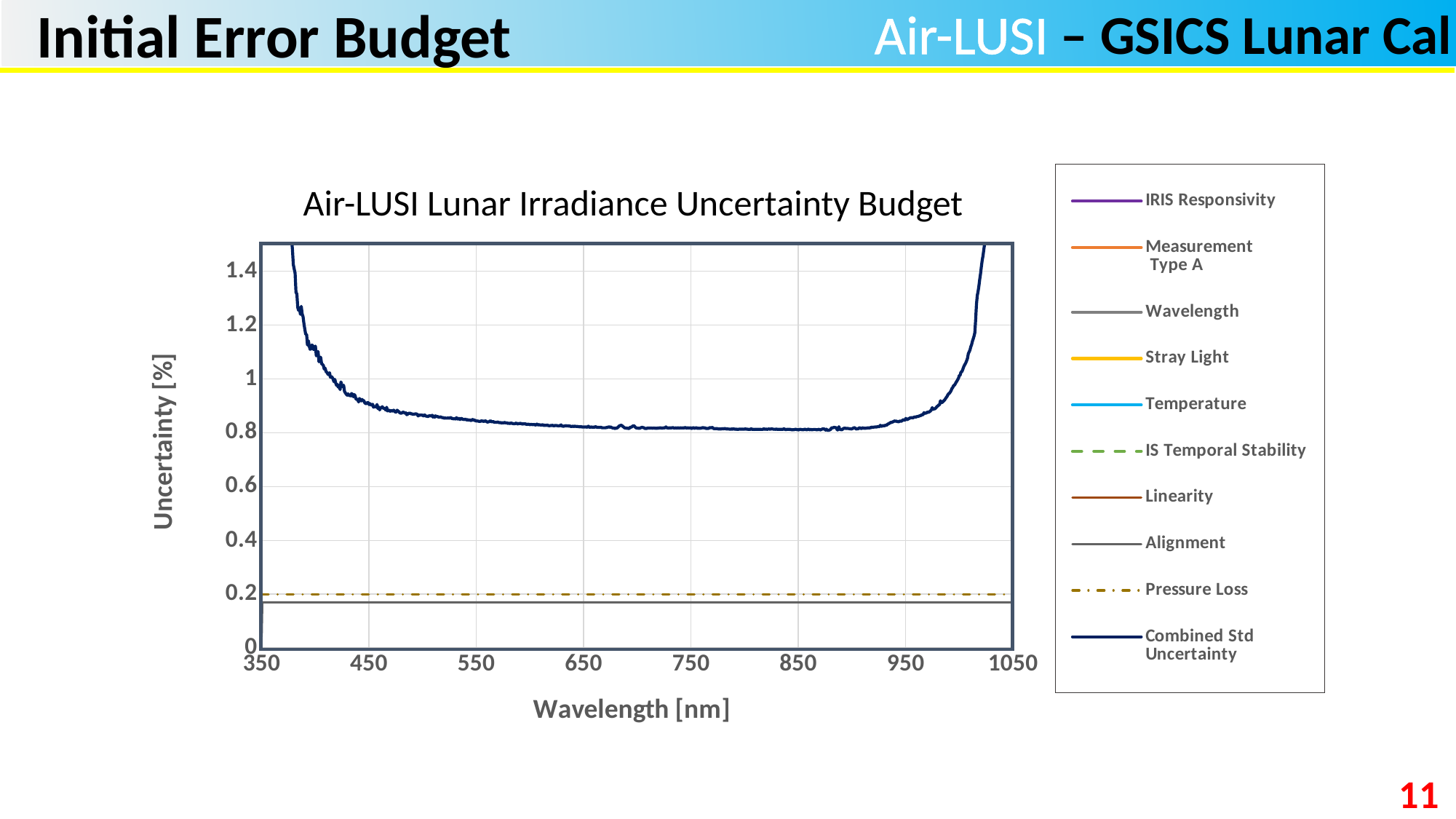
Is the Combined Std Uncertainty value at 450 nm greater or less than 0.8? greater What is the label of the chart's y axis? Uncertainty [%] Does the Combined Std Uncertainty line rise or fall between 350 nm and 550 nm? fall What kind of chart is shown on the slide? line chart At 650 nm, which is larger: Combined Std Uncertainty or Pressure Loss? Combined Std Uncertainty Is the Combined Std Uncertainty value at 750 nm greater or less than 1? less How many series does the chart legend list? 10 Is the Combined Std Uncertainty value at 450 nm greater or less than 1.2? less Does the Combined Std Uncertainty line rise or fall between 950 nm and 1050 nm? rise Which series has the highest values across the plotted wavelength range? Combined Std Uncertainty What is the title of the chart? Air-LUSI Lunar Irradiance Uncertainty Budget